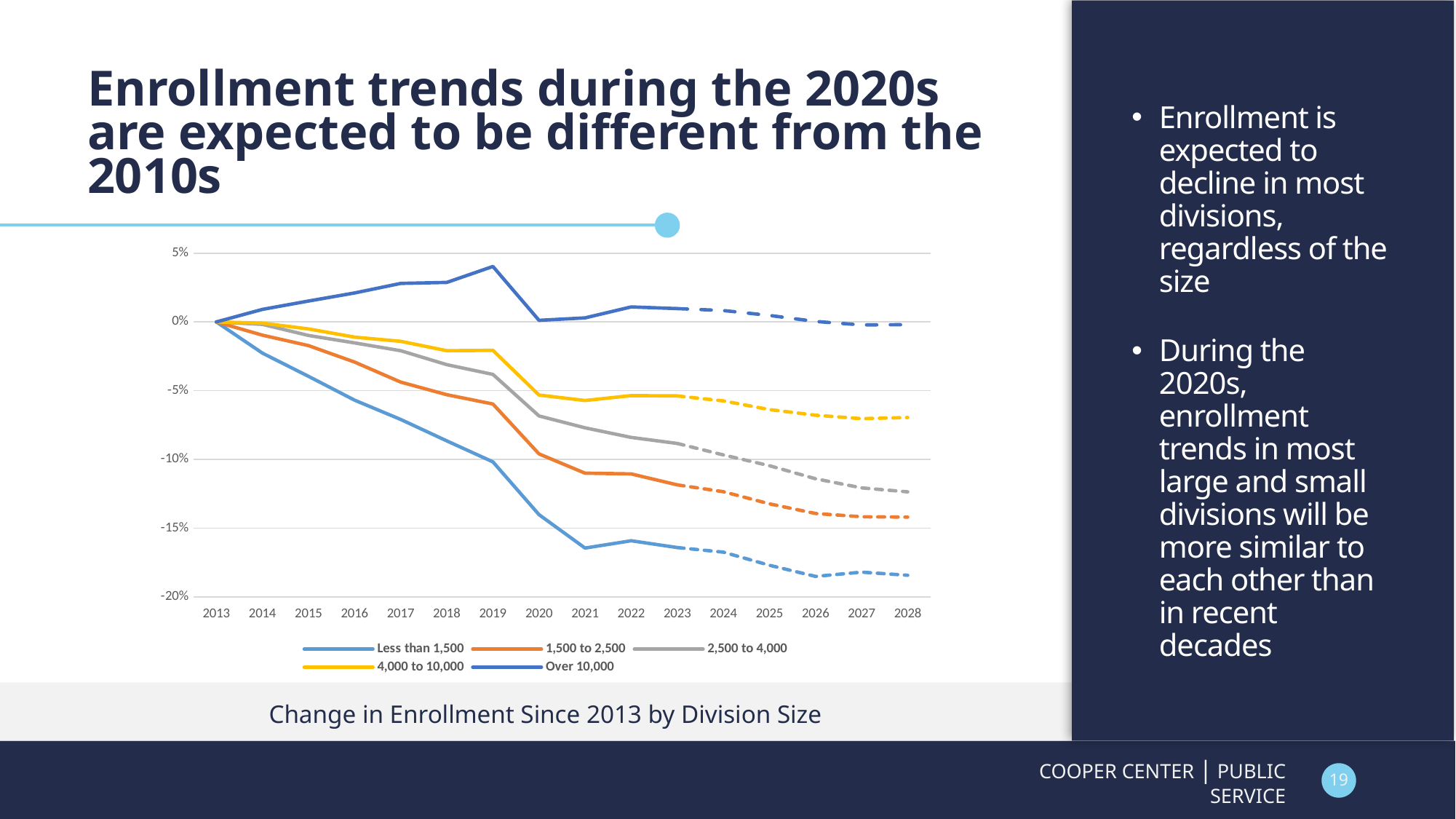
Which series has the lowest value in 2028? Less than 1,500 Is the value for 'Less than 1,500' in 2021 greater or less than -15%? less Does the 'Less than 1,500' series rise or fall from 2013 to 2021? fall Is the value for '4,000 to 10,000' in 2028 greater or less than -5%? less In 2023, which is larger: the value for '2,500 to 4,000' or the value for '1,500 to 2,500'? 2,500 to 4,000 Which series has the highest value in 2028? Over 10,000 How many series does the legend list? 5 How many years are shown on the x axis? 16 What kind of chart is shown on the slide? line chart Is the value for 'Over 10,000' in 2019 greater or less than 0%? greater What is the value for the 'Less than 1,500' series in 2013? 0% What is the caption shown below the chart? Change in Enrollment Since 2013 by Division Size